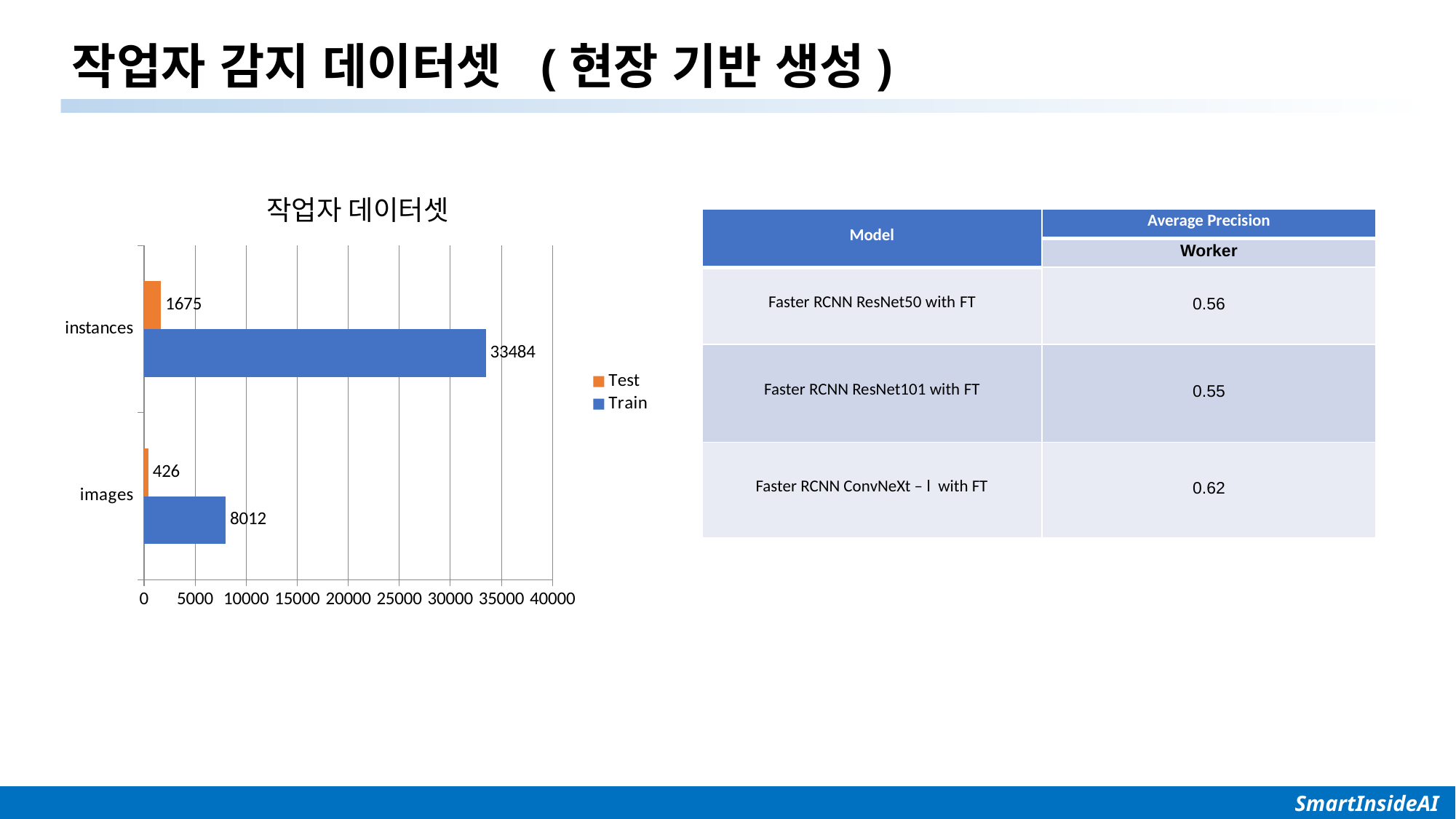
Which category has the lowest Test value? images What kind of chart is shown on the slide? Bar chart What is the difference between the Train and Test values for instances? 31809 Which is larger, the Train value for images or the Test value for instances? Train value for images Which category has the highest Train value? instances What is the Train value for images? 8012 What is the difference between the Train and Test values for images? 7586 How many series does the legend list? 2 What is the Test value for instances? 1675 How many categories are shown on the chart? 2 What is the Test value for images? 426 What is the Train value for instances? 33484